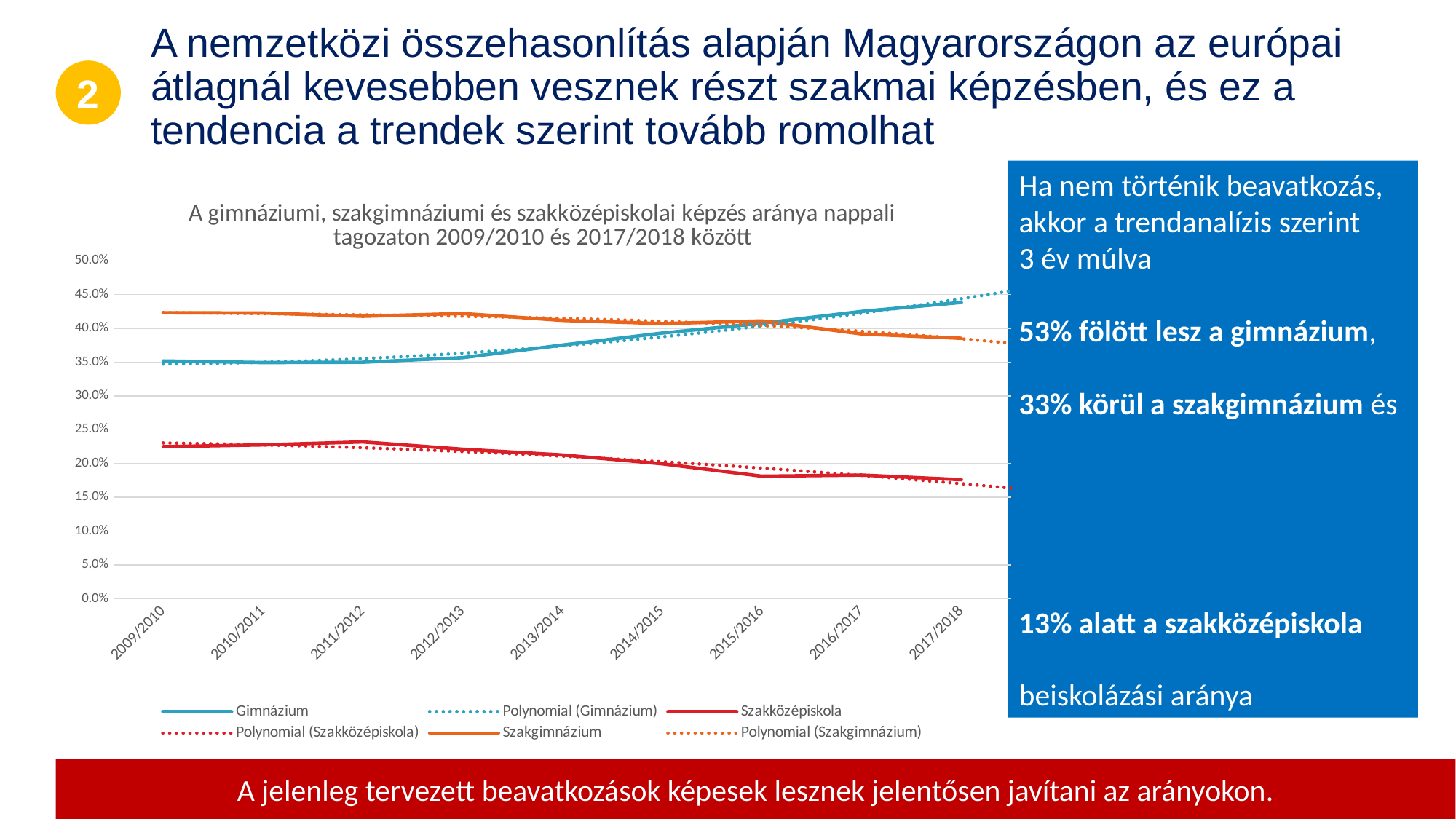
In 2017/2018, which is larger: Gimnázium or Szakgimnázium? Gimnázium Does the Szakközépiskola series rise or fall from 2009/2010 to 2017/2018? fall Does the Gimnázium series rise or fall from 2009/2010 to 2017/2018? rise How many entries does the chart legend list? 6 Is the value for Szakközépiskola in 2017/2018 greater or less than 20.0%? less Which series has the highest value in 2017/2018? Gimnázium What kind of chart is shown on the slide? line chart Is the value for Gimnázium in 2017/2018 greater or less than 40.0%? greater Which series has the highest value in 2009/2010? Szakgimnázium Which series has the lowest value in 2017/2018? Szakközépiskola What is the title of the chart? A gimnáziumi, szakgimnáziumi és szakközépiskolai képzés aránya nappali tagozaton 2009/2010 és 2017/2018 között How many school years are shown on the x axis of the chart? 9